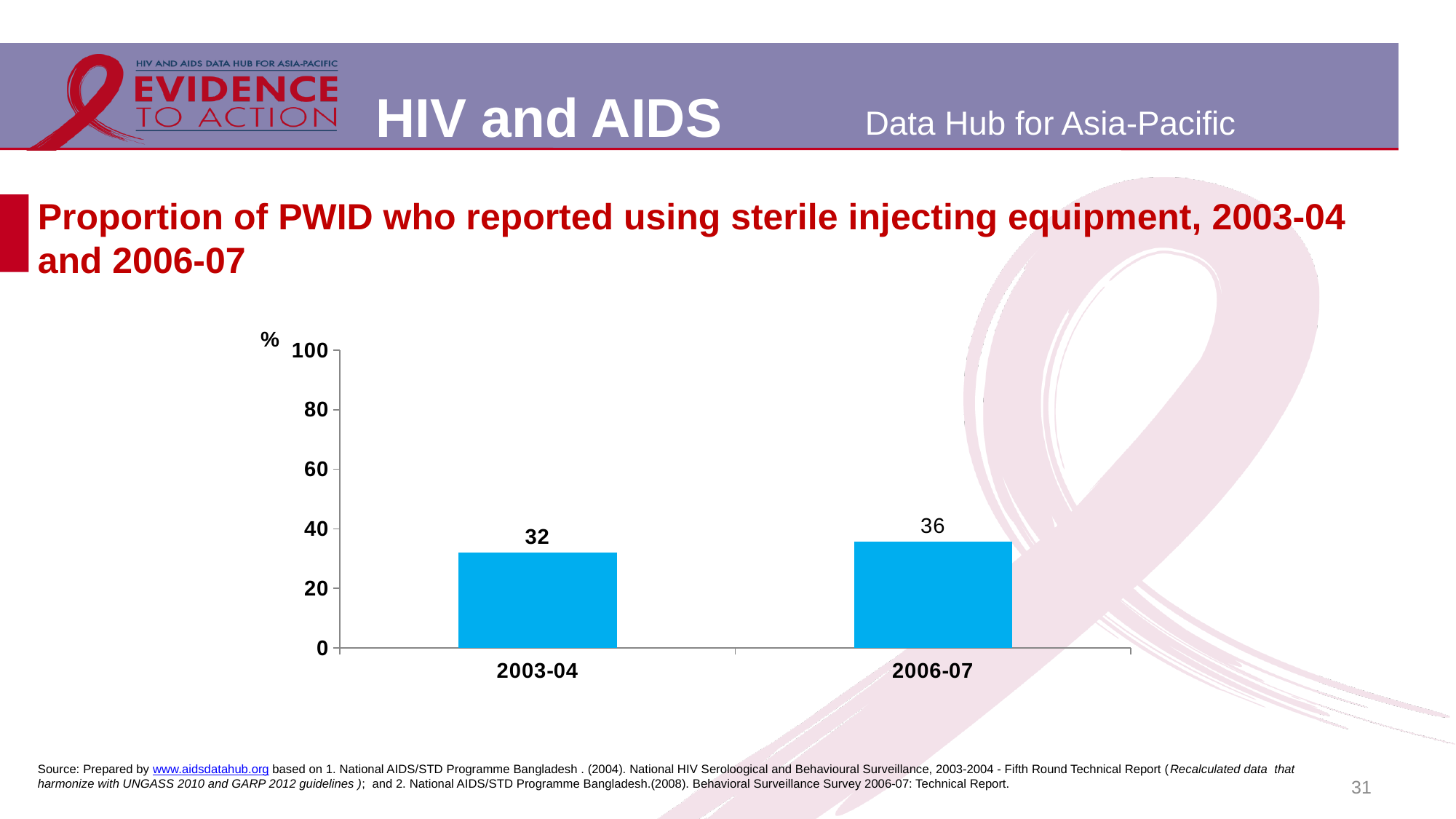
What kind of chart is shown on the slide? bar chart What is the difference between the values for 2006-07 and 2003-04? 4 What unit is shown on the y axis of the chart? % Do the values rise or fall from 2003-04 to 2006-07? rise What is the value for 2003-04? 32 Is the value for 2006-07 greater or less than 20? greater How many categories are shown on the x axis? 2 Which period has the higher value? 2006-07 Is the value for 2003-04 greater or less than 40? less Is the value for 2006-07 larger or smaller than the value for 2003-04? larger Which period has the lower value? 2003-04 What is the value for 2006-07? 36